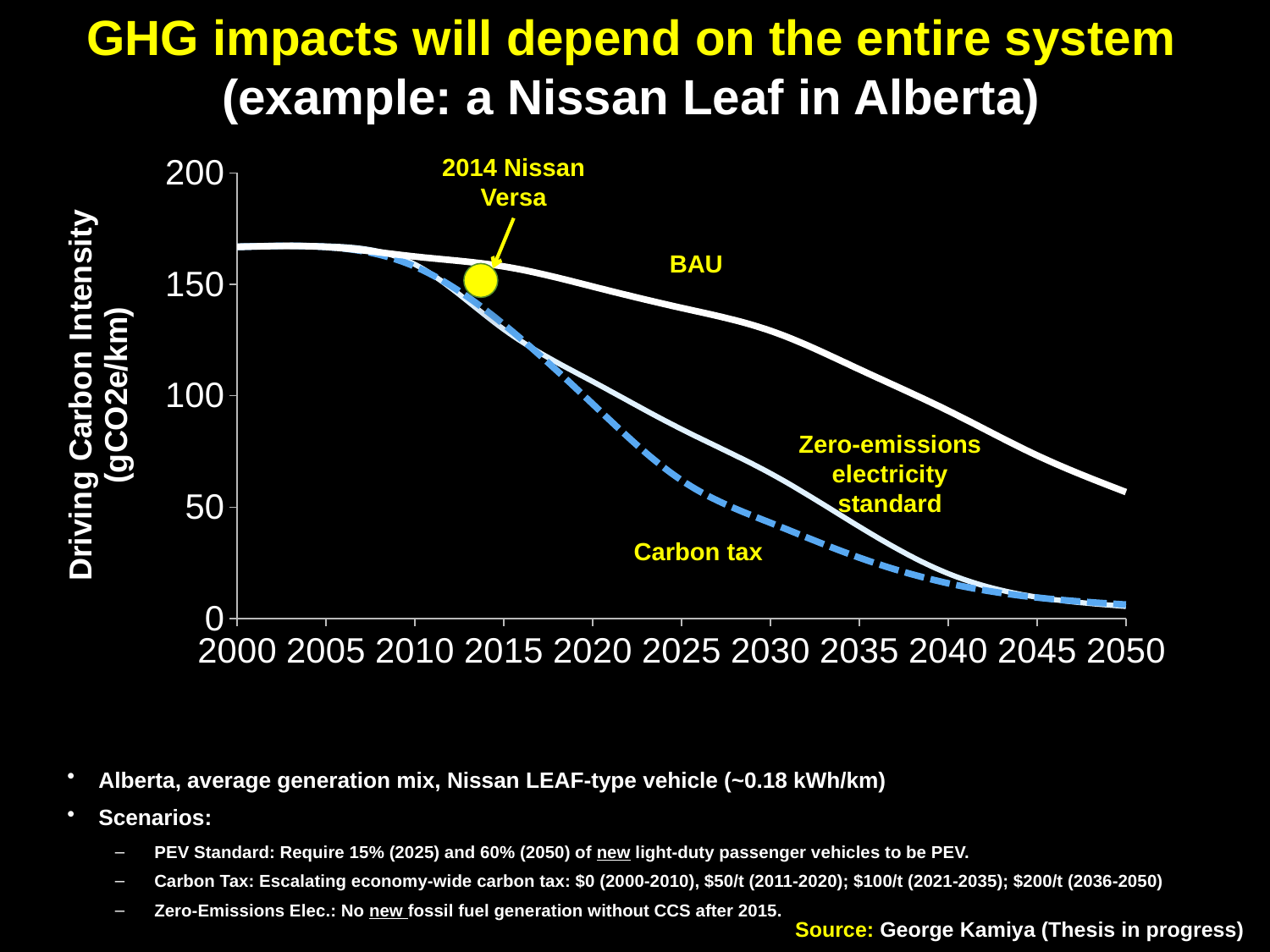
Which scenario has the highest driving carbon intensity in 2050? BAU In 2025, which scenario has the larger value, Zero-emissions electricity standard or Carbon tax? Zero-emissions electricity standard Is the value for the BAU scenario in 2010 greater or less than 150? greater Does the BAU line rise or fall between 2010 and 2050? fall How many scenario lines are plotted on the chart? 3 What kind of chart is shown on the slide? line chart Is the value for the BAU scenario in 2030 greater or less than 100? greater What is the label of the y axis? Driving Carbon Intensity (gCO2e/km) Is the value for the Carbon tax scenario in 2030 greater or less than 50? less In 2030, which scenario has the larger value, BAU or Carbon tax? BAU Which scenario line is drawn as a dashed line? Carbon tax